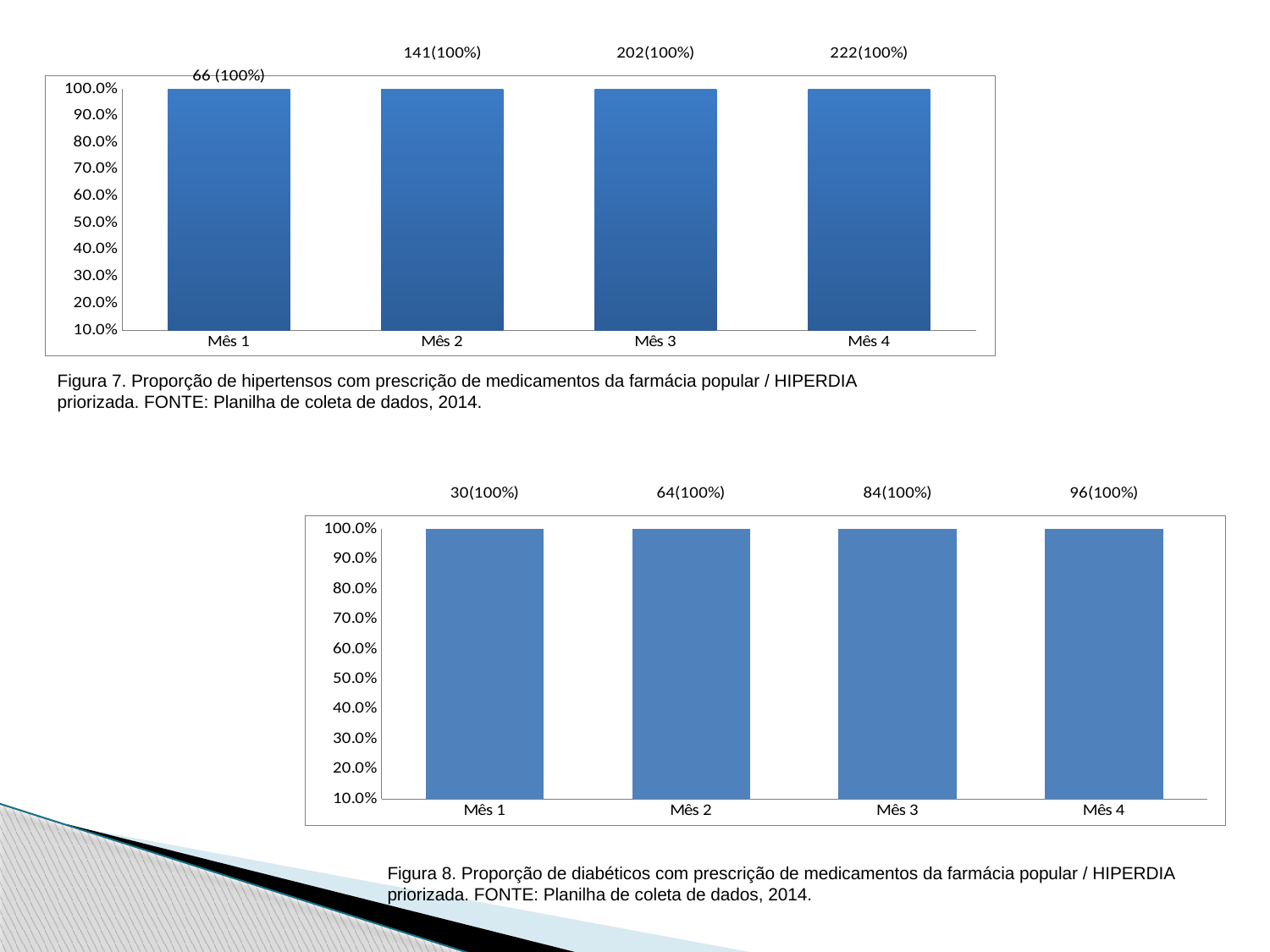
In the top chart (Figura 7), what percentage value do all four bars reach? 100.0% In the top chart (Figura 7), what is the data label shown above the bar for Mês 1? 66 (100%) In the bottom chart (Figura 8), what is the data label shown above the bar for Mês 1? 30(100%) What is the lowest value shown on the vertical axis of the bottom chart (Figura 8)? 10.0% In the bottom chart (Figura 8), is the value for Mês 3 greater or less than 50.0%? greater In the top chart (Figura 7), what is the data label shown above the bar for Mês 4? 222(100%) In the bottom chart (Figura 8), what is the data label shown above the bar for Mês 4? 96(100%) What kind of chart is the top chart (Figura 7)? Bar chart In the top chart (Figura 7), what is the data label shown above the bar for Mês 3? 202(100%) How many bars (months) are plotted in the top chart (Figura 7)? 4 How many bars (months) are plotted in the bottom chart (Figura 8)? 4 In the bottom chart (Figura 8), what is the data label shown above the bar for Mês 2? 64(100%)